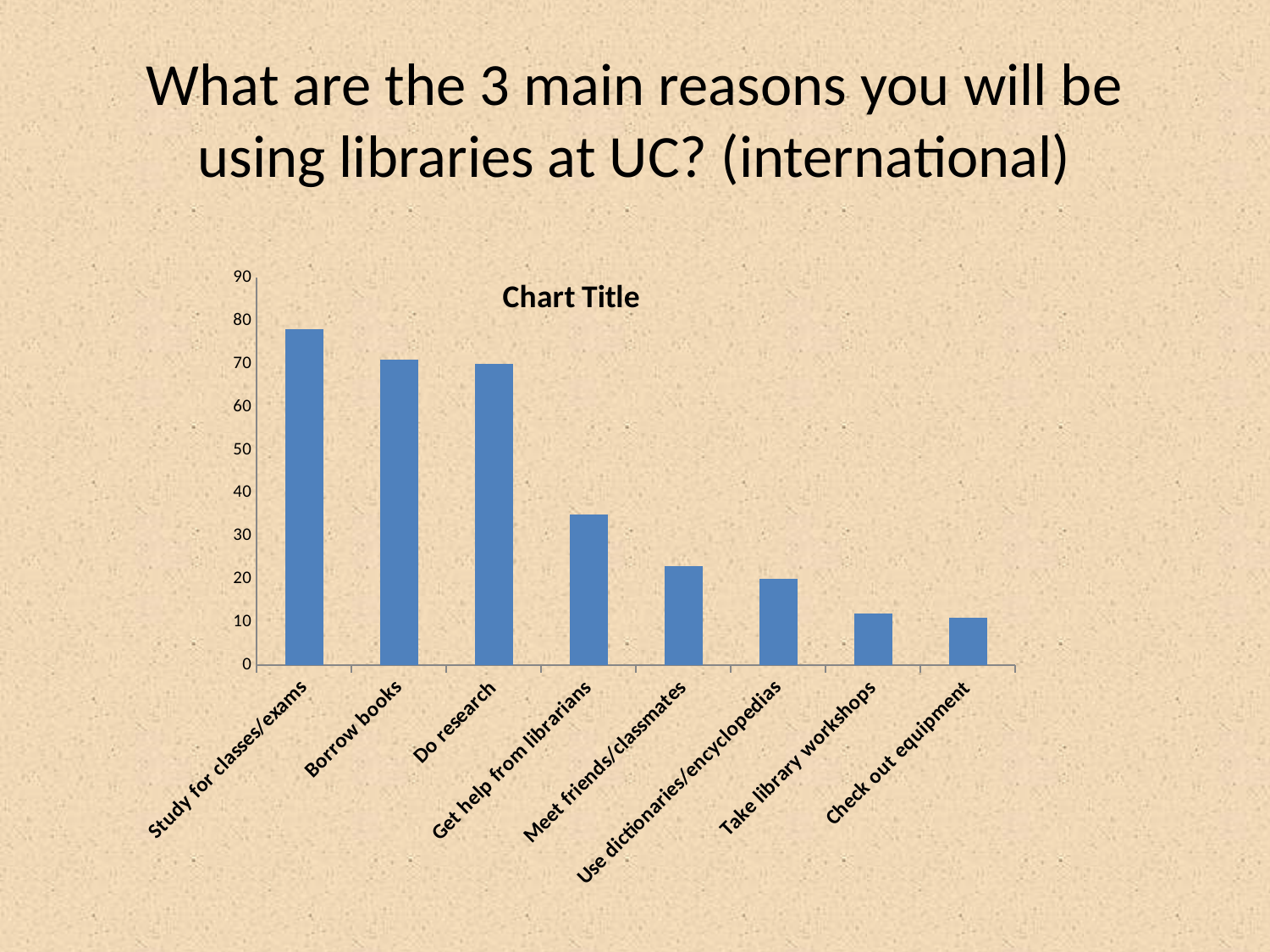
Is the value for Study for classes/exams greater or less than 70? greater Which category has the highest value in the chart? Study for classes/exams What kind of chart is shown on the slide? bar chart Is the value for Meet friends/classmates greater or less than 30? less Is the value for Check out equipment greater or less than 20? less Which is larger, the value for Get help from librarians or the value for Meet friends/classmates? Get help from librarians What is the title printed inside the chart area? Chart Title How many categories are shown on the x axis of the chart? 8 Do the values rise or fall moving from left to right along the x axis? fall